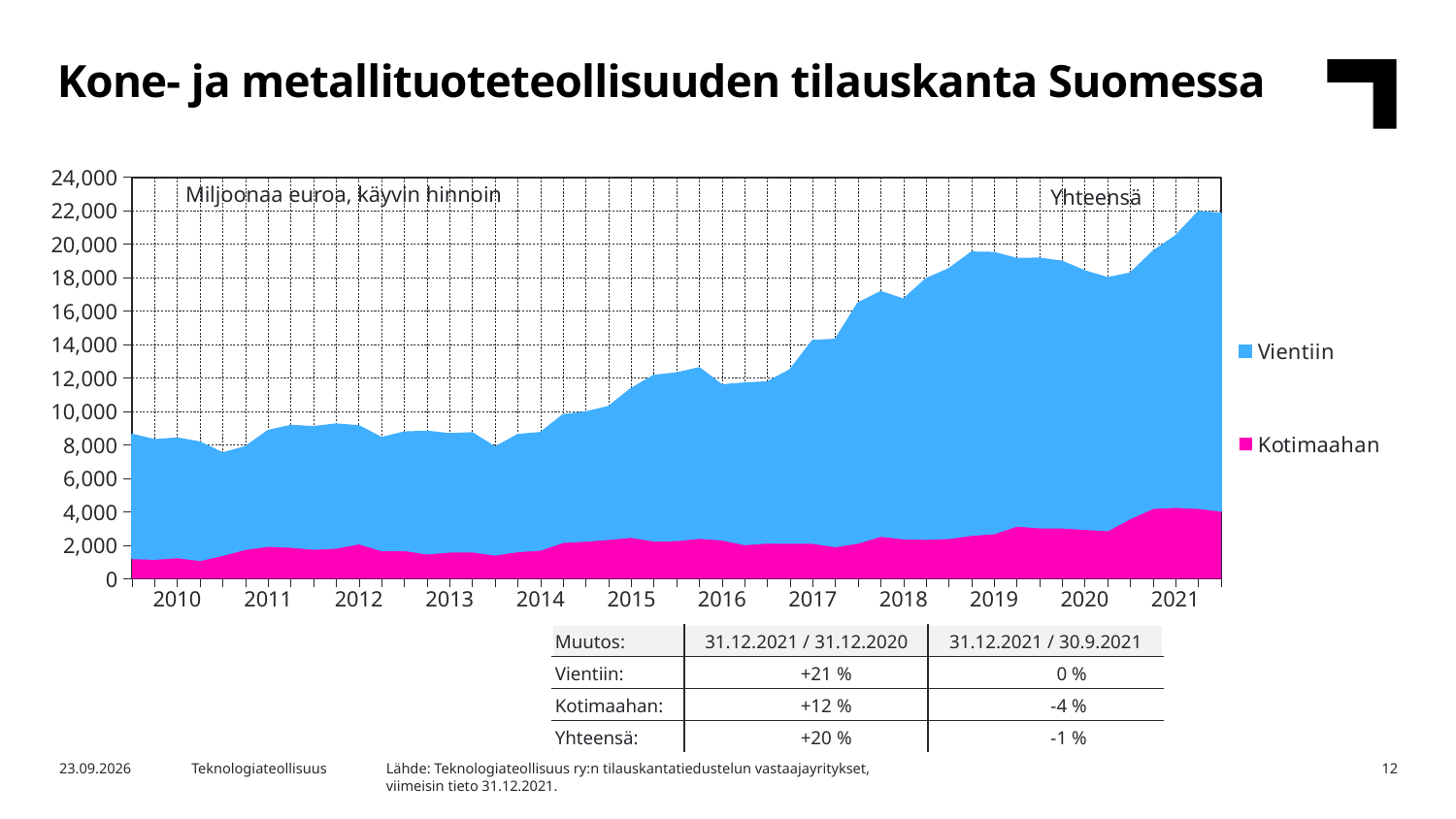
Is the total (Yhteensä) value in 2016 greater or less than 14,000? less What unit note is printed inside the chart area at the top left? Miljoonaa euroa, käyvin hinnoin Is the total (Yhteensä) value at the start of 2010 greater or less than 10,000? less Is the total (Yhteensä) value at the end of 2021 greater or less than 20,000? greater What kind of chart is shown on the slide? Stacked area chart How many years are labelled on the x axis of the chart? 12 How many series does the chart legend list? 2 Which series is larger throughout the chart, Vientiin or Kotimaahan? Vientiin Which two series are listed in the chart legend? Vientiin and Kotimaahan Does the total order backlog (Yhteensä) rise or fall overall from 2010 to 2021? rise